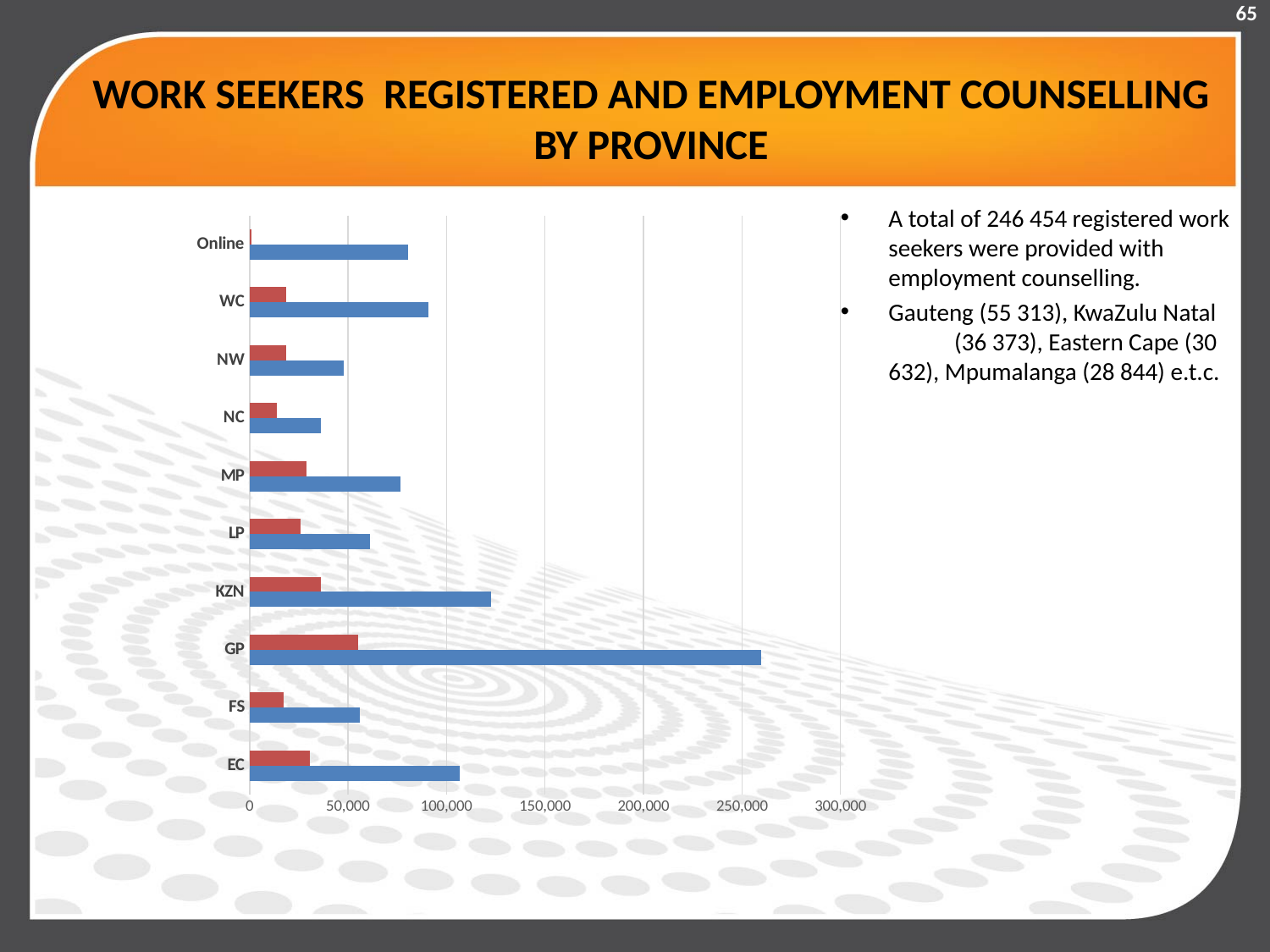
Is the blue bar for GP greater or less than 250,000? greater Which category has the shortest red bar? Online Which category has the shortest blue bar? NC Which has the larger blue bar, KZN or WC? KZN What kind of chart is shown on the slide? bar chart Which category has the longest red bar? GP Is the blue bar for WC greater or less than 100,000? less How many categories are listed on the vertical axis of the chart? 10 Is the blue bar for KZN greater or less than 100,000? greater How many bars are plotted for each category in the chart? 2 Which category has the longest blue bar? GP